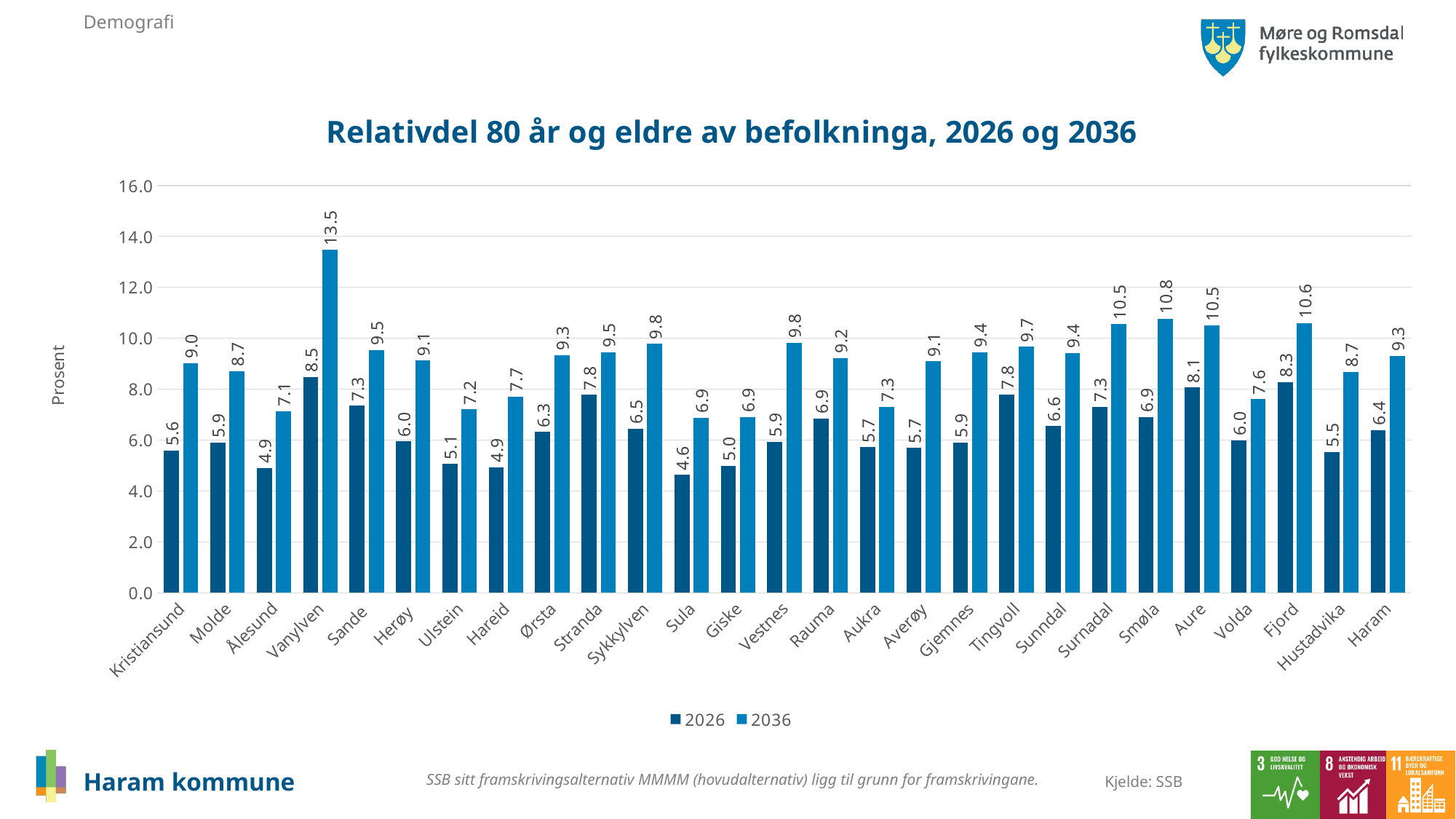
What is the value for Haram in 2036? 9.3 What is the difference between the 2036 and 2026 values for Vanylven? 5.0 How many municipalities are shown on the x axis? 27 How many series does the legend list? 2 What is the value for Sula in 2026? 4.6 Is the 2036 value for Vanylven greater or less than 12.0? greater Which is larger, the 2036 value for Smøla or the 2036 value for Fjord? Smøla Which municipality has the highest value for 2036? Vanylven What is the difference between the 2036 and 2026 values for Haram? 2.9 What type of chart is shown on the slide? Bar chart What is the value for Vanylven in 2026? 8.5 Which municipality has the lowest value for 2026? Sula